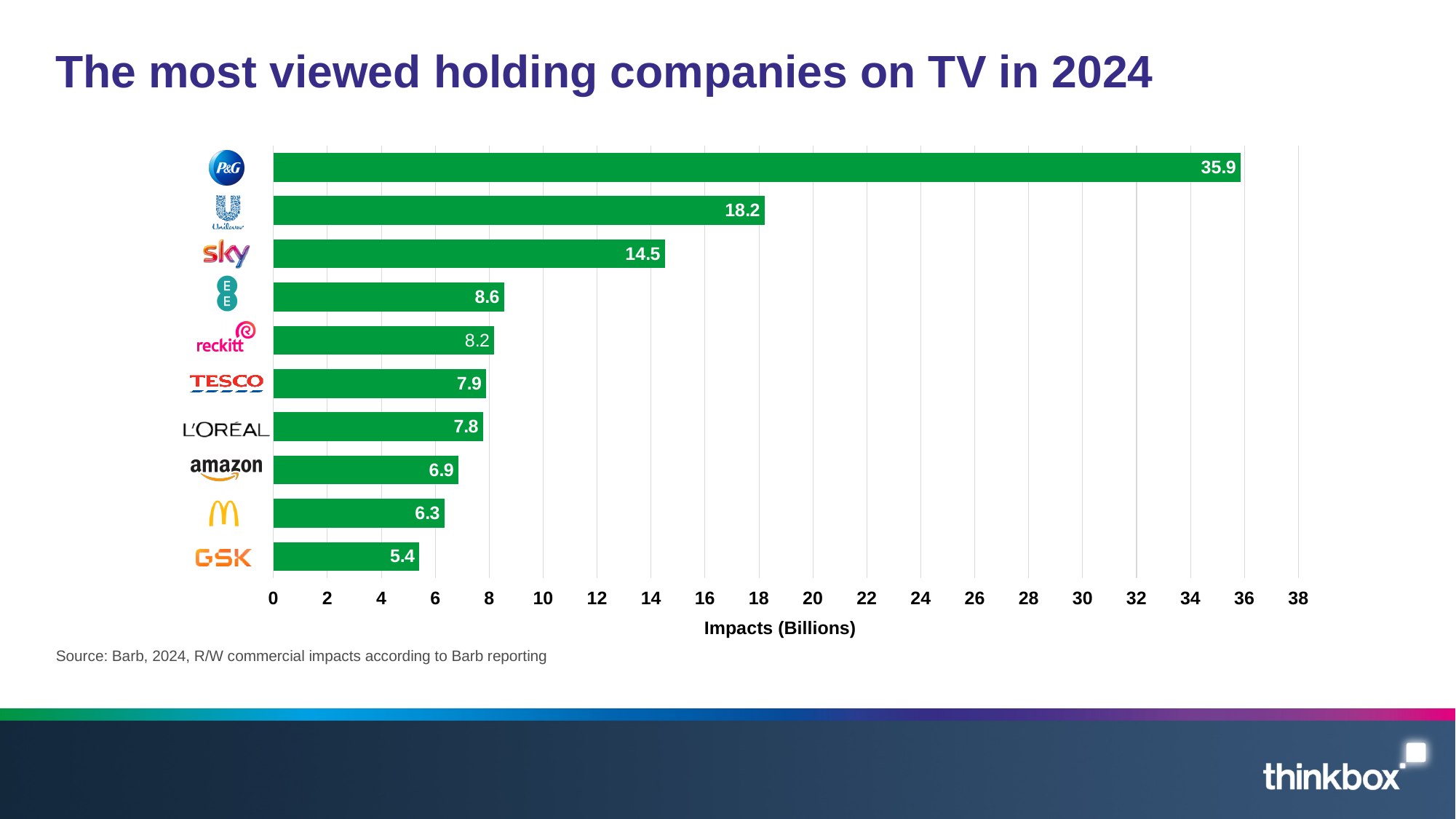
What is the difference between the values for P&G and Unilever? 17.7 What is the value for Tesco? 7.9 What is the value for Sky? 14.5 What kind of chart is shown on the slide? Bar chart What is the label of the horizontal axis? Impacts (Billions) What is the value for GSK? 5.4 Which company has the highest number of impacts? P&G What is the value for P&G? 35.9 How many companies are shown in the chart? 10 Which is larger, the value for Unilever or the value for Sky? Unilever Which company has the lowest number of impacts? GSK What is the difference between the values for EE and Amazon? 1.7